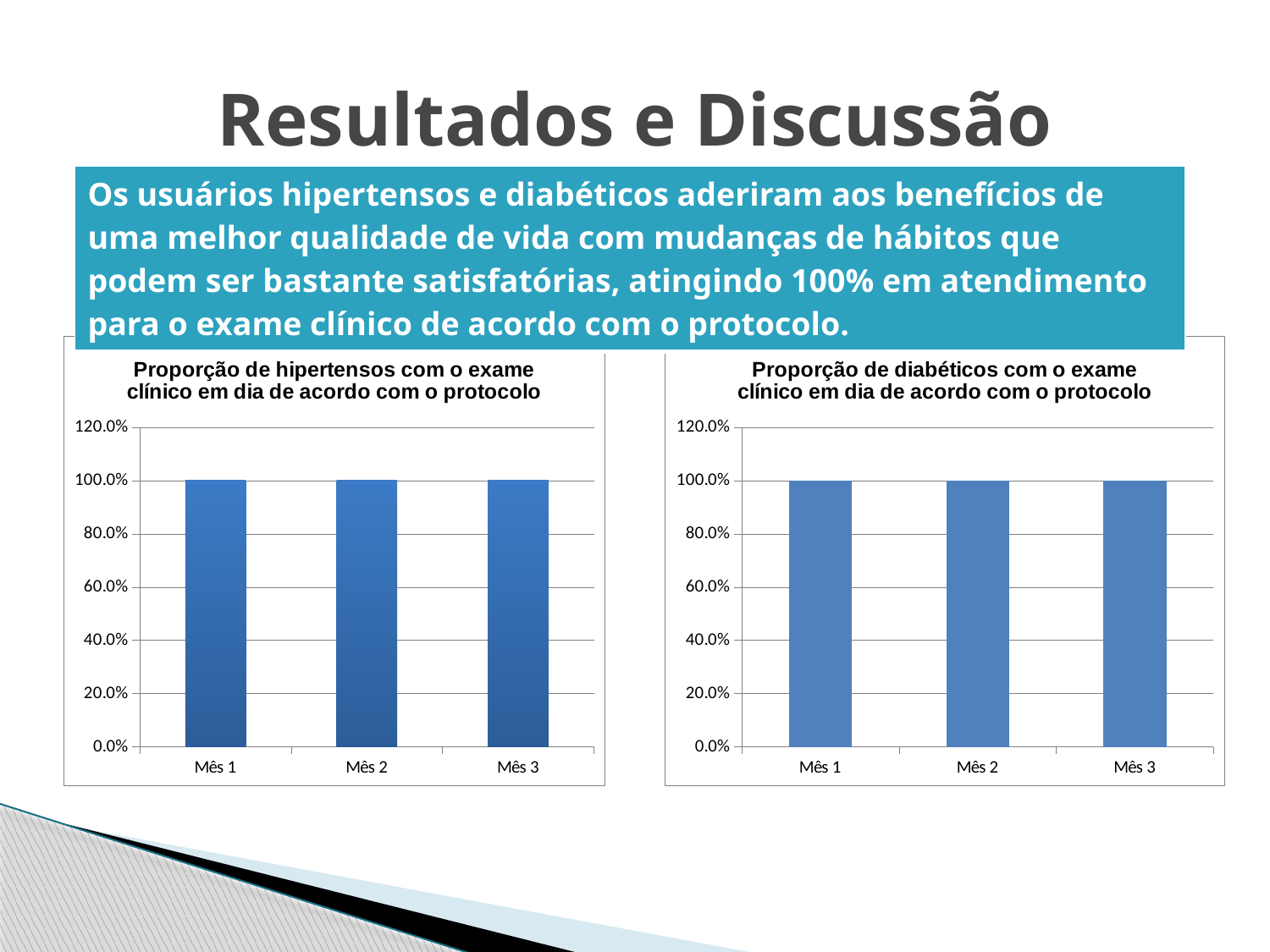
How many categories are shown on the x axis of the left chart (hipertensos)? 3 In the left chart (hipertensos), do the values rise, fall or stay the same from Mês 1 to Mês 3? Stay the same In the left chart (hipertensos), what is the value for Mês 2? 100.0% In the right chart (diabéticos), is the value for Mês 1 greater or less than 80.0%? greater How many bars are plotted in the right chart (diabéticos)? 3 In the right chart (diabéticos), do the values rise, fall or stay the same from Mês 1 to Mês 3? Stay the same What is the title of the left chart? Proporção de hipertensos com o exame clínico em dia de acordo com o protocolo In the chart titled "Proporção de hipertensos com o exame clínico em dia de acordo com o protocolo", what is the value for Mês 1? 100.0% What kind of chart is the left chart (hipertensos)? Bar chart In the chart titled "Proporção de diabéticos com o exame clínico em dia de acordo com o protocolo", what is the value for Mês 3? 100.0% What kind of chart is the right chart (diabéticos)? Bar chart In the right chart (diabéticos), what is the value for Mês 2? 100.0%